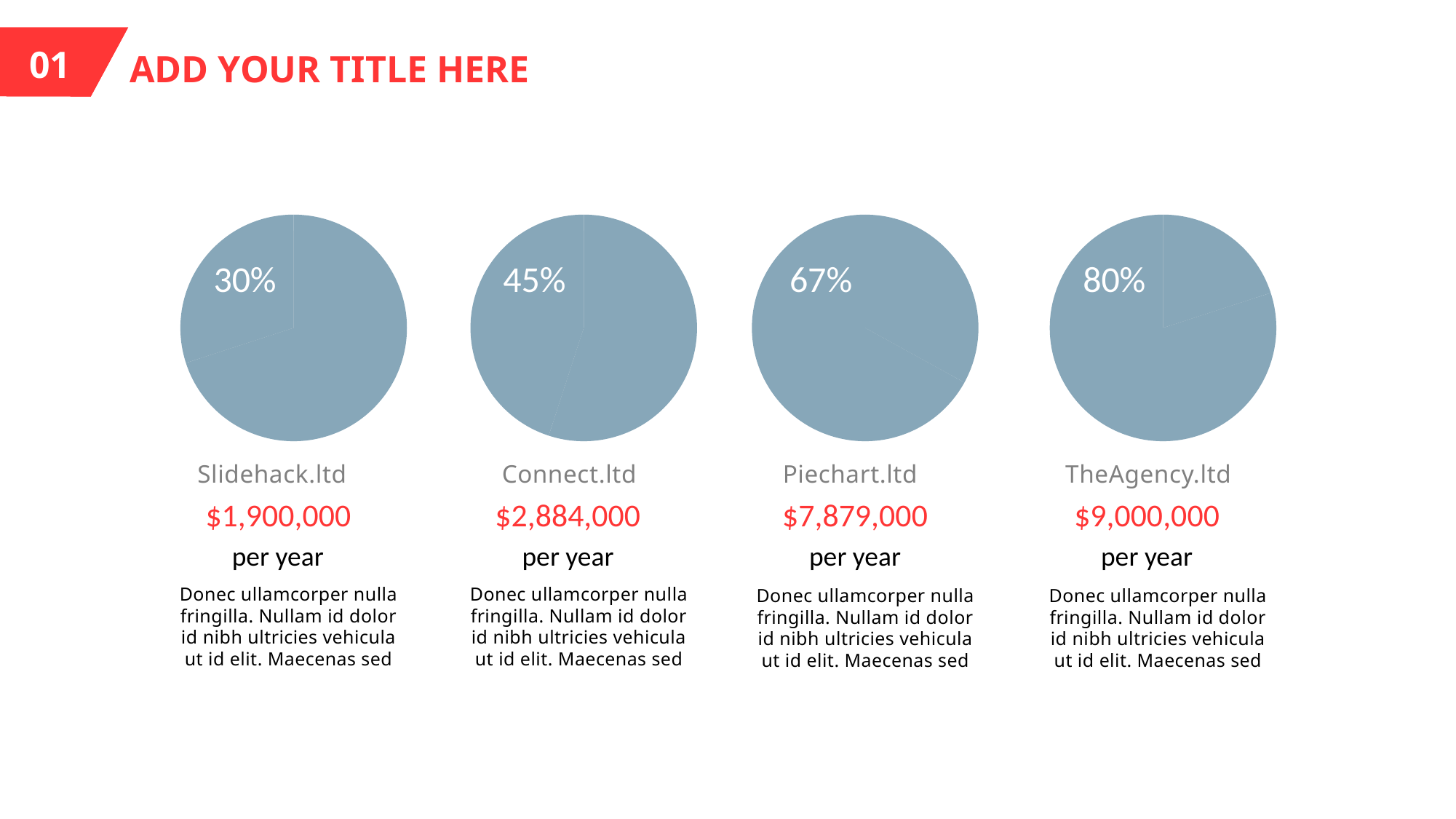
What percentage is shown on the Slidehack.ltd pie chart? 30% What is the difference between the percentage on the TheAgency.ltd pie chart and the percentage on the Slidehack.ltd pie chart? 50 percentage points What percentage is shown on the Piechart.ltd pie chart? 67% What is the title of the slide containing the four pie charts? ADD YOUR TITLE HERE How many pie charts are on the slide? 4 What is the difference between the percentage on the Piechart.ltd pie chart and the percentage on the Connect.ltd pie chart? 22 percentage points Which company's pie chart shows the lowest percentage? Slidehack.ltd What kind of chart is shown above the label Slidehack.ltd? pie chart Which pie chart shows a larger percentage, Connect.ltd or Piechart.ltd? Piechart.ltd Which company's pie chart shows the highest percentage? TheAgency.ltd What percentage is shown on the Connect.ltd pie chart? 45% What percentage is shown on the TheAgency.ltd pie chart? 80%